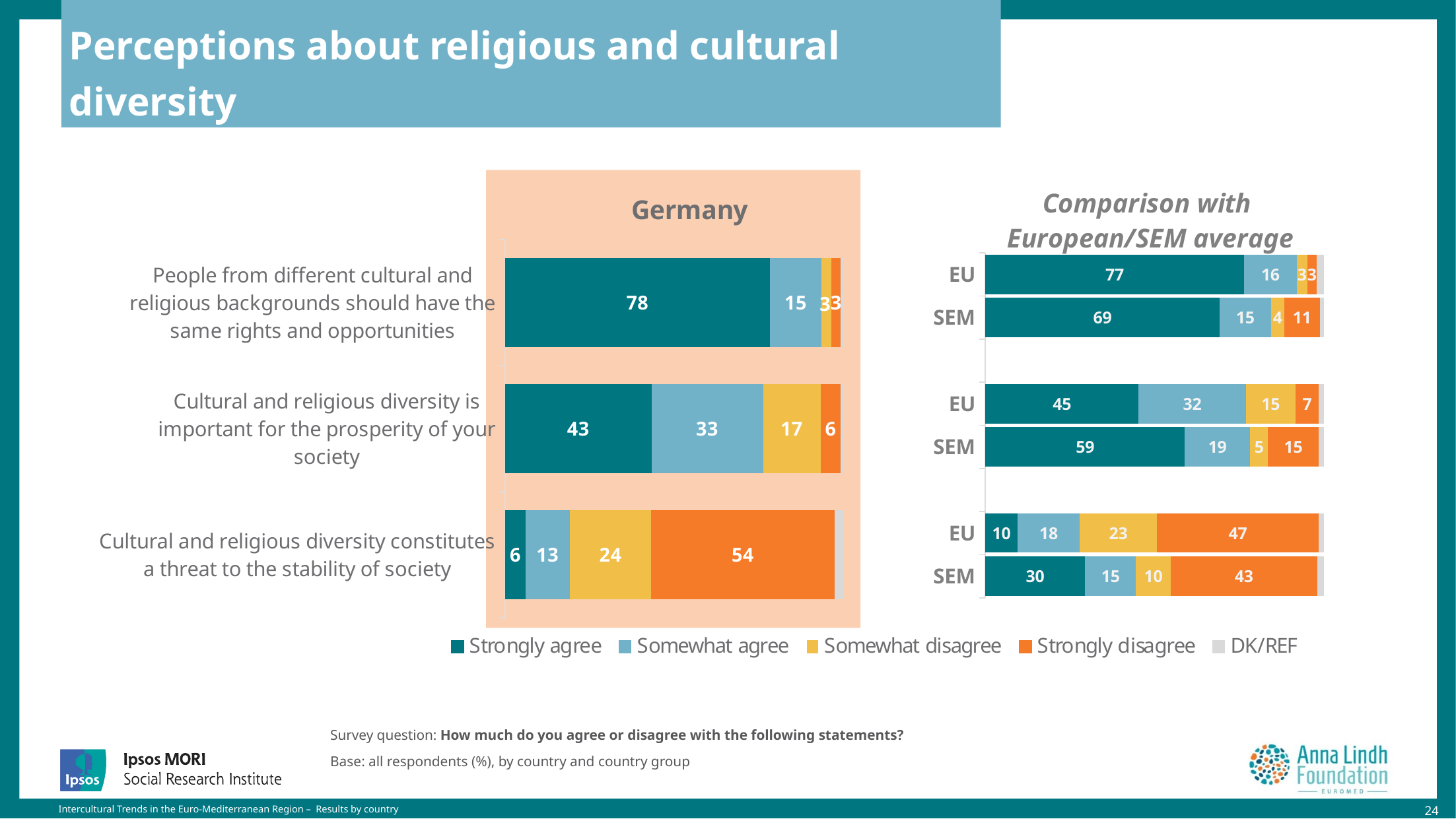
How many series does the legend list? 5 In the Germany chart, which statement has the lowest 'Strongly agree' value? Cultural and religious diversity constitutes a threat to the stability of society In the Germany chart, what percentage strongly agree that people from different cultural and religious backgrounds should have the same rights and opportunities? 78 In the Comparison with European/SEM average chart, which is larger for the statement about diversity being important for prosperity: the EU 'Strongly agree' value or the SEM 'Strongly agree' value? SEM What kind of chart is the Germany chart? Stacked bar chart In the Germany chart, what is the 'Somewhat agree' value for the statement that cultural and religious diversity is important for the prosperity of your society? 33 In the Germany chart, which statement has the highest 'Strongly agree' value? People from different cultural and religious backgrounds should have the same rights and opportunities In the Comparison with European/SEM average chart, what is the SEM 'Strongly agree' value for the statement that diversity constitutes a threat to the stability of society? 30 In the Comparison with European/SEM average chart, what is the EU 'Strongly disagree' value for the statement that diversity constitutes a threat to the stability of society? 47 In the Germany chart, what percentage strongly disagree that cultural and religious diversity constitutes a threat to the stability of society? 54 In the Comparison with European/SEM average chart, what is the difference between the SEM and EU 'Strongly disagree' values for the statement about same rights and opportunities? 8 In the Germany chart, what is the difference between the 'Strongly agree' and 'Somewhat agree' values for the statement about diversity being important for prosperity? 10